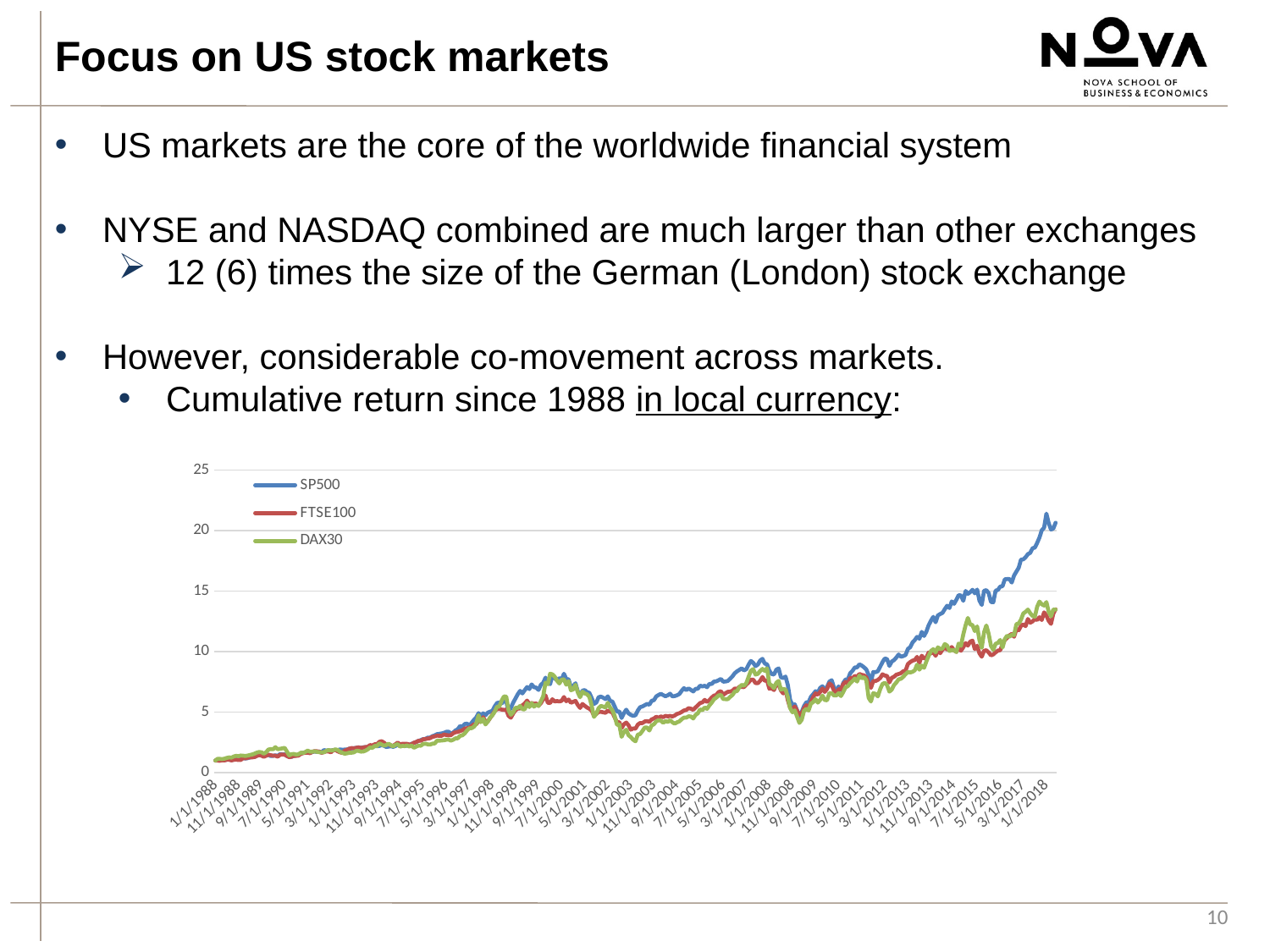
At the end of the chart (2018), which is larger, SP500 or FTSE100? SP500 Is the value of DAX30 at its 2003 low greater or less than 5? less Overall, do the cumulative return series rise or fall from 1988 to 2018? rise Which series is plotted in blue in the chart? SP500 Is the value of DAX30 at the end of the chart (2018) greater or less than 15? less Which series has the highest value at the end of the chart (2018)? SP500 Is the value of SP500 at the end of the chart (2018) greater or less than 15? greater Which series is plotted in green in the chart? DAX30 How many series does the chart legend list? 3 What kind of chart is shown on the slide? line chart